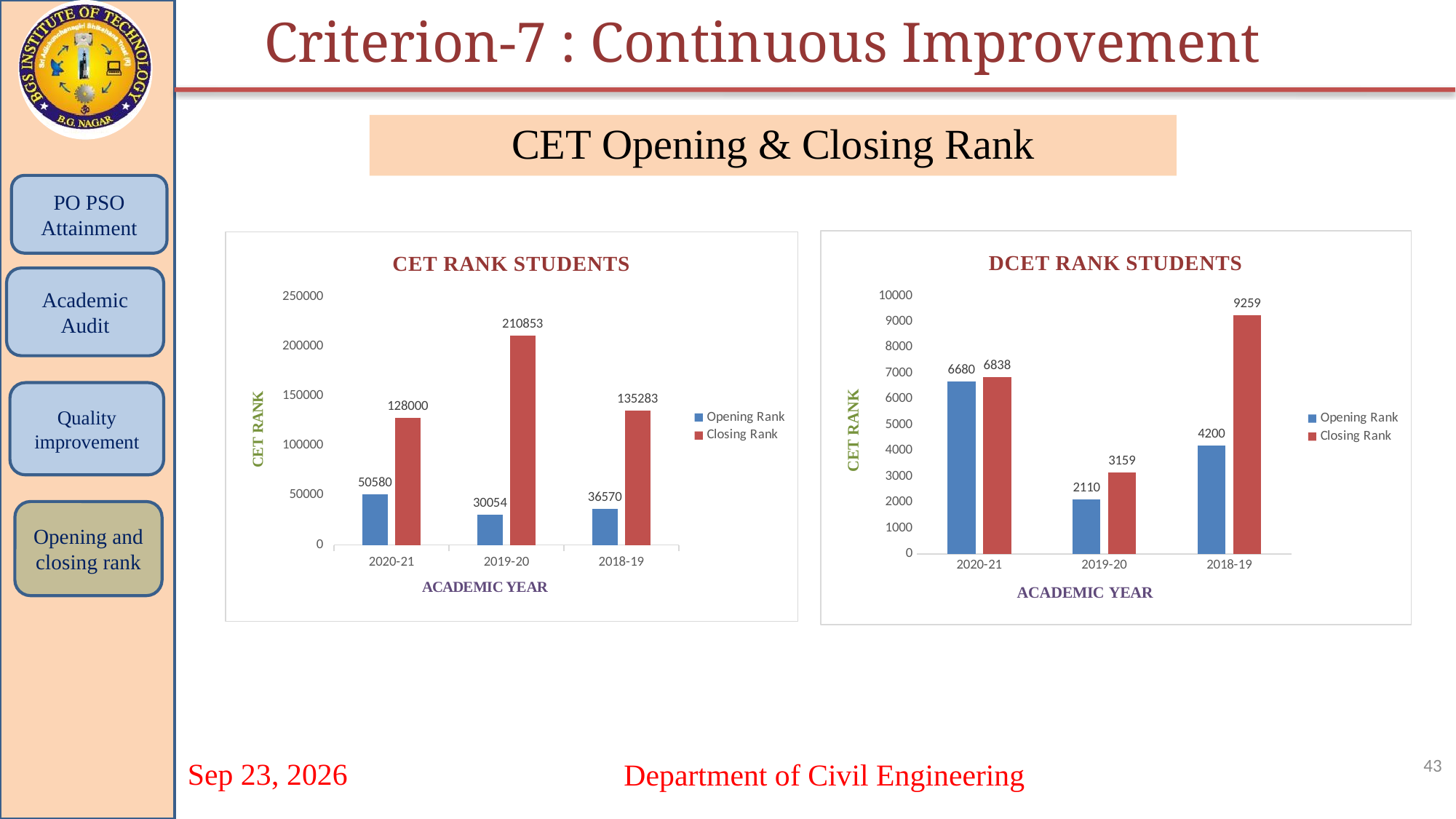
In the DCET RANK STUDENTS chart, what is the Opening Rank for 2019-20? 2110 What kind of chart is the DCET RANK STUDENTS chart? Bar chart In the CET RANK STUDENTS chart, what is the Closing Rank for 2019-20? 210853 In the CET RANK STUDENTS chart, which academic year has the highest Closing Rank? 2019-20 How many series does the legend of the CET RANK STUDENTS chart list? 2 In the DCET RANK STUDENTS chart, which academic year has the lowest Opening Rank? 2019-20 In the CET RANK STUDENTS chart, what is the Opening Rank for 2020-21? 50580 In the DCET RANK STUDENTS chart, what is the difference between the Closing Rank and Opening Rank for 2020-21? 158 How many academic years are shown on the x axis of the DCET RANK STUDENTS chart? 3 In the CET RANK STUDENTS chart, what is the difference between the Closing Rank and Opening Rank for 2018-19? 98713 In the DCET RANK STUDENTS chart, what is the Closing Rank for 2018-19? 9259 In the CET RANK STUDENTS chart, which is larger: the Opening Rank for 2020-21 or the Opening Rank for 2018-19? Opening Rank for 2020-21